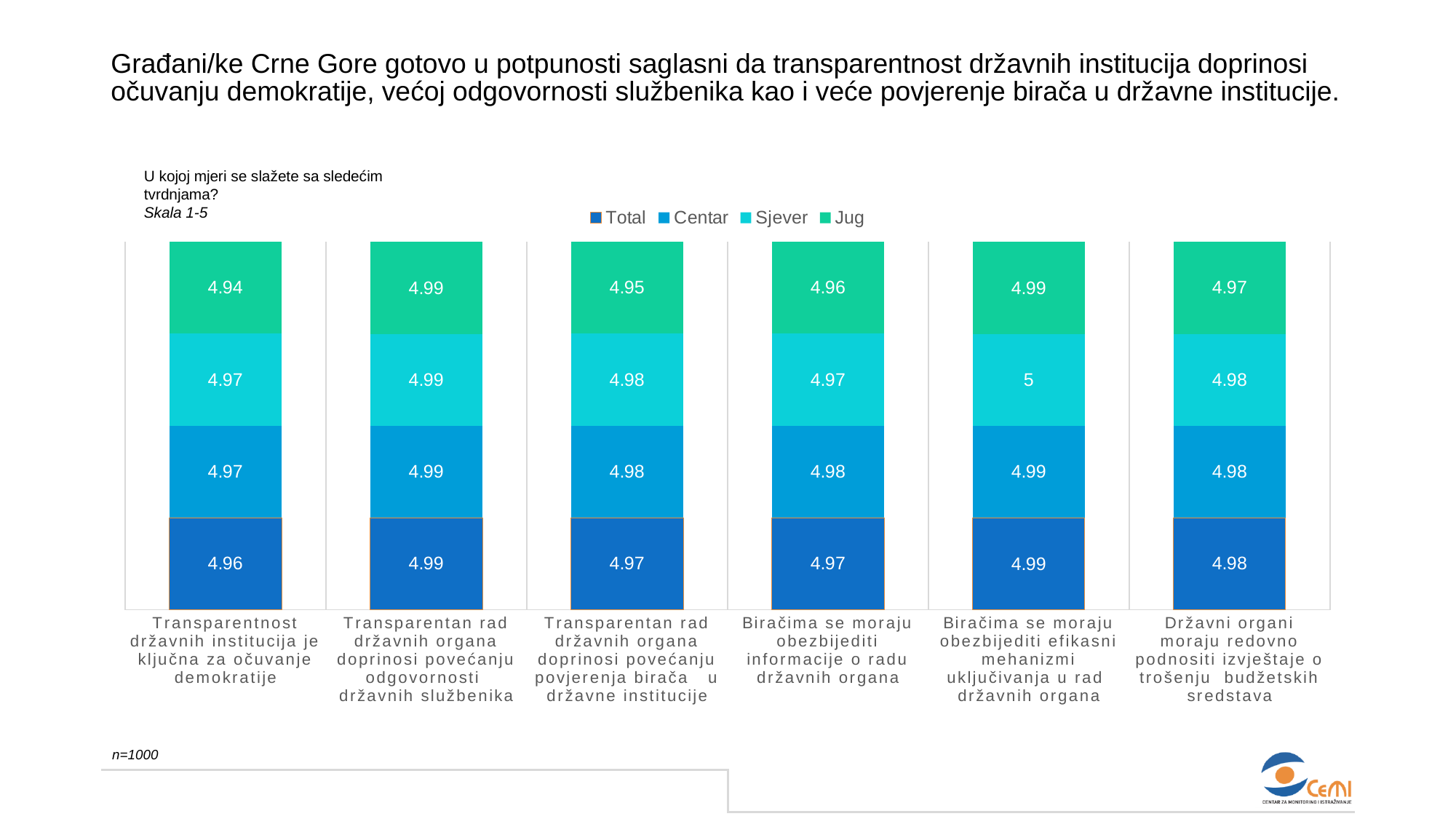
Which is larger: the Jug value for "Transparentnost državnih institucija je ključna za očuvanje demokratije" or the Jug value for "Transparentan rad državnih organa doprinosi povećanju odgovornosti državnih službenika"? Transparentan rad državnih organa doprinosi povećanju odgovornosti državnih službenika Which category has the highest Sjever value? Biračima se moraju obezbijediti efikasni mehanizmi uključivanja u rad državnih organa What is the total of the stacked bar for "Transparentan rad državnih organa doprinosi povećanju odgovornosti državnih službenika"? 19.96 What kind of chart is shown on the slide? Stacked bar chart What is the Total value for "Državni organi moraju redovno podnositi izvještaje o trošenju budžetskih sredstava"? 4.98 How many categories are shown on the x axis? 6 What is the Jug value for "Transparentnost državnih institucija je ključna za očuvanje demokratije"? 4.94 Which category has the lowest Jug value? Transparentnost državnih institucija je ključna za očuvanje demokratije What is the difference between the Centar and Jug values for "Transparentnost državnih institucija je ključna za očuvanje demokratije"? 0.03 What is the Sjever value for "Biračima se moraju obezbijediti efikasni mehanizmi uključivanja u rad državnih organa"? 5 What is the Centar value for "Biračima se moraju obezbijediti informacije o radu državnih organa"? 4.98 How many series does the legend list? 4